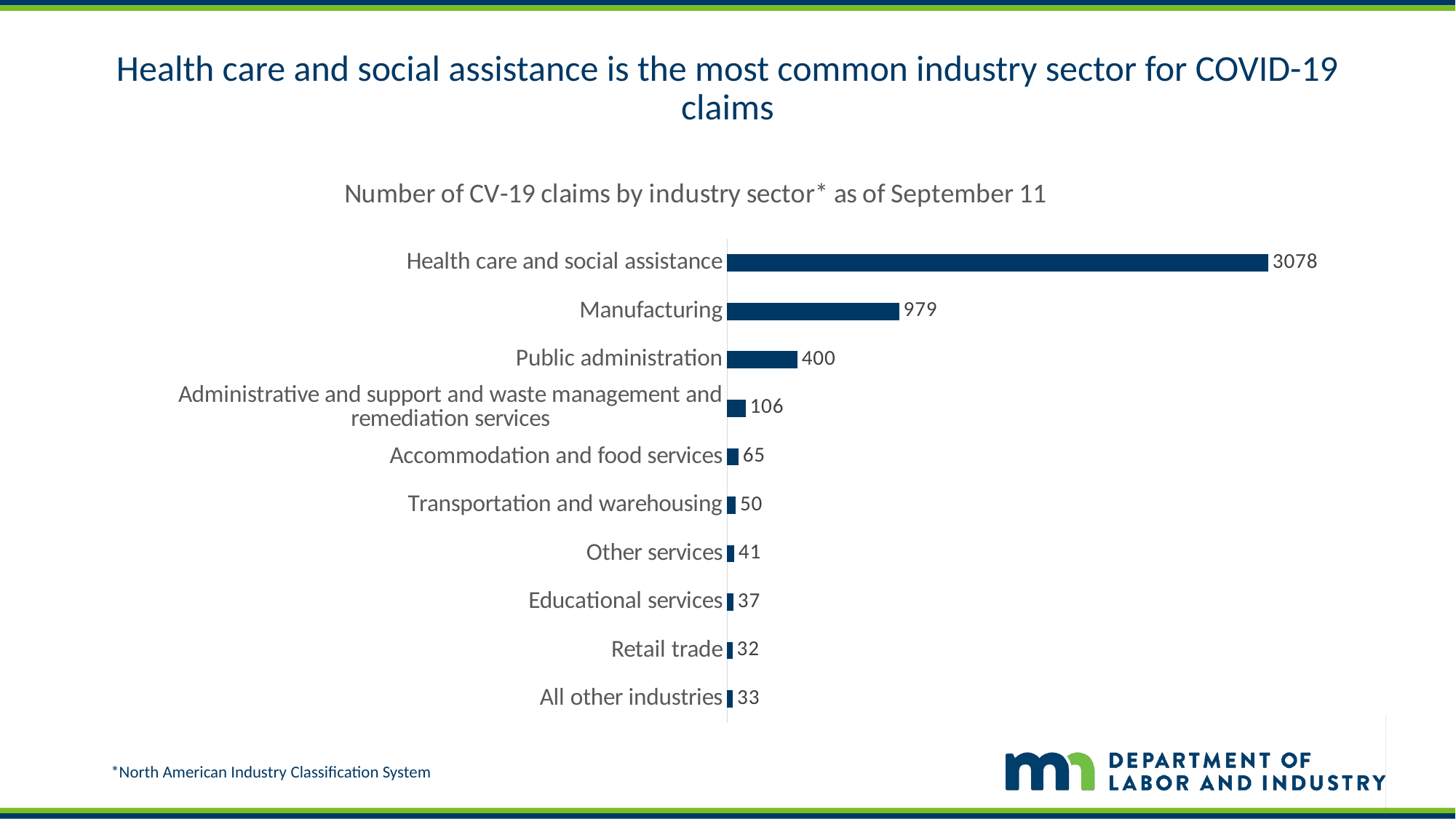
What is the title of the chart? Number of CV-19 claims by industry sector* as of September 11 How many industry sectors are shown in the chart? 10 Which has more claims, Transportation and warehousing or Other services? Transportation and warehousing What is the difference in claims between Public administration and Accommodation and food services? 335 Which industry sector has the highest number of claims? Health care and social assistance How many claims are shown for Retail trade? 32 How many CV-19 claims are shown for Health care and social assistance? 3078 What is the difference in claims between Health care and social assistance and Manufacturing? 2099 What kind of chart is shown on the slide? Bar chart Which industry sector has the lowest number of claims? Retail trade What is the number of claims for Manufacturing? 979 What is the value shown for Administrative and support and waste management and remediation services? 106